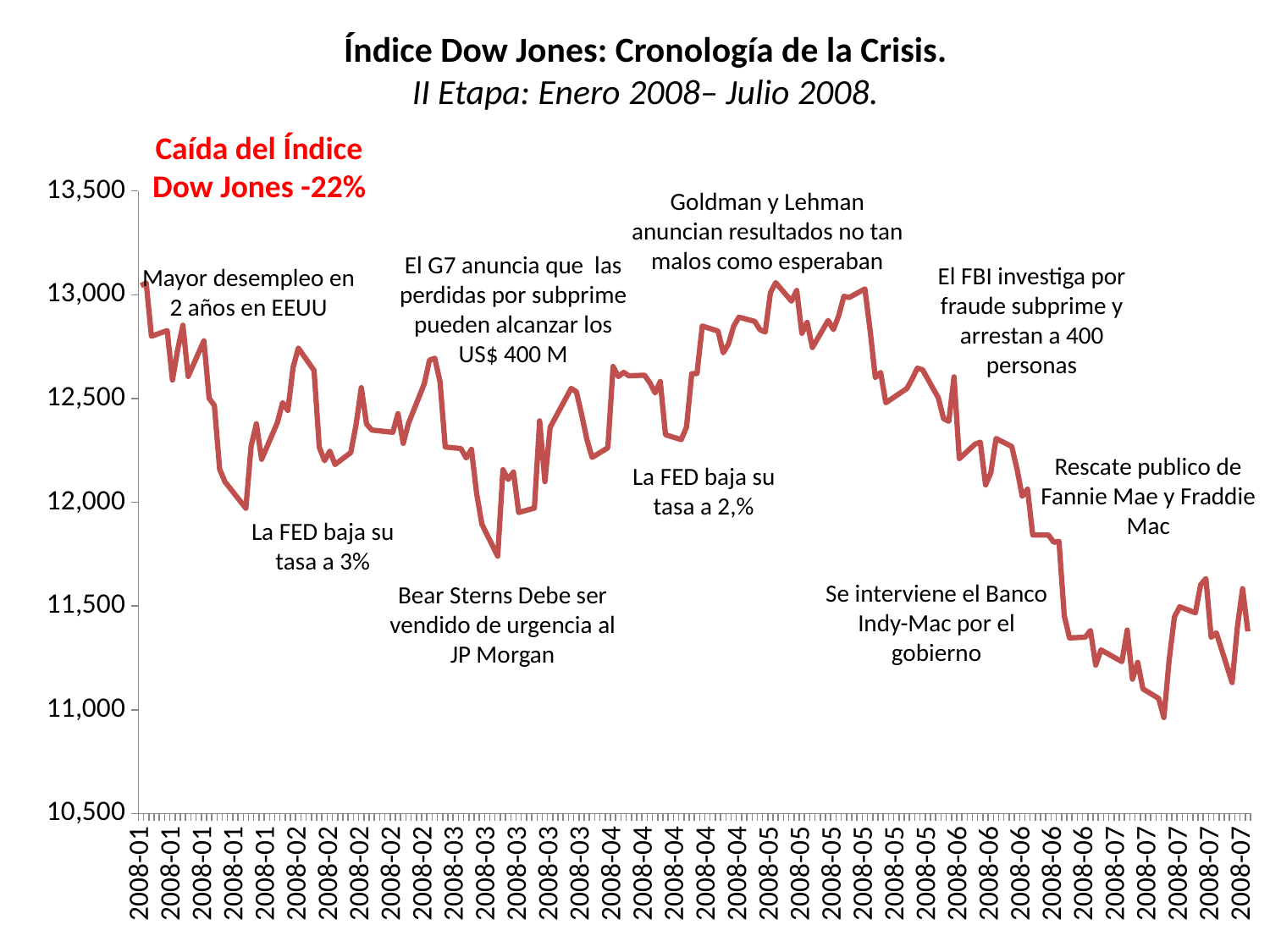
Is the value of the index at the start of 2008-01 greater or less than 12,500? greater Overall, does the Dow Jones index rise or fall from January 2008 to July 2008? fall According to the red text on the slide, by what percentage did the Dow Jones index fall? -22% Is the lowest value of the index in 2008-03 greater or less than 12,000? less What kind of chart is shown on the slide? line chart How many data series are plotted on the chart? 1 Is the lowest value of the index in 2008-07 greater or less than 11,500? less Which is lower: the lowest point of the index in March 2008 or the lowest point in July 2008? July 2008 What period does the chart's subtitle say the second stage covers? Enero 2008 – Julio 2008 Is the index higher at the start of January 2008 or at the end of July 2008? start of January 2008